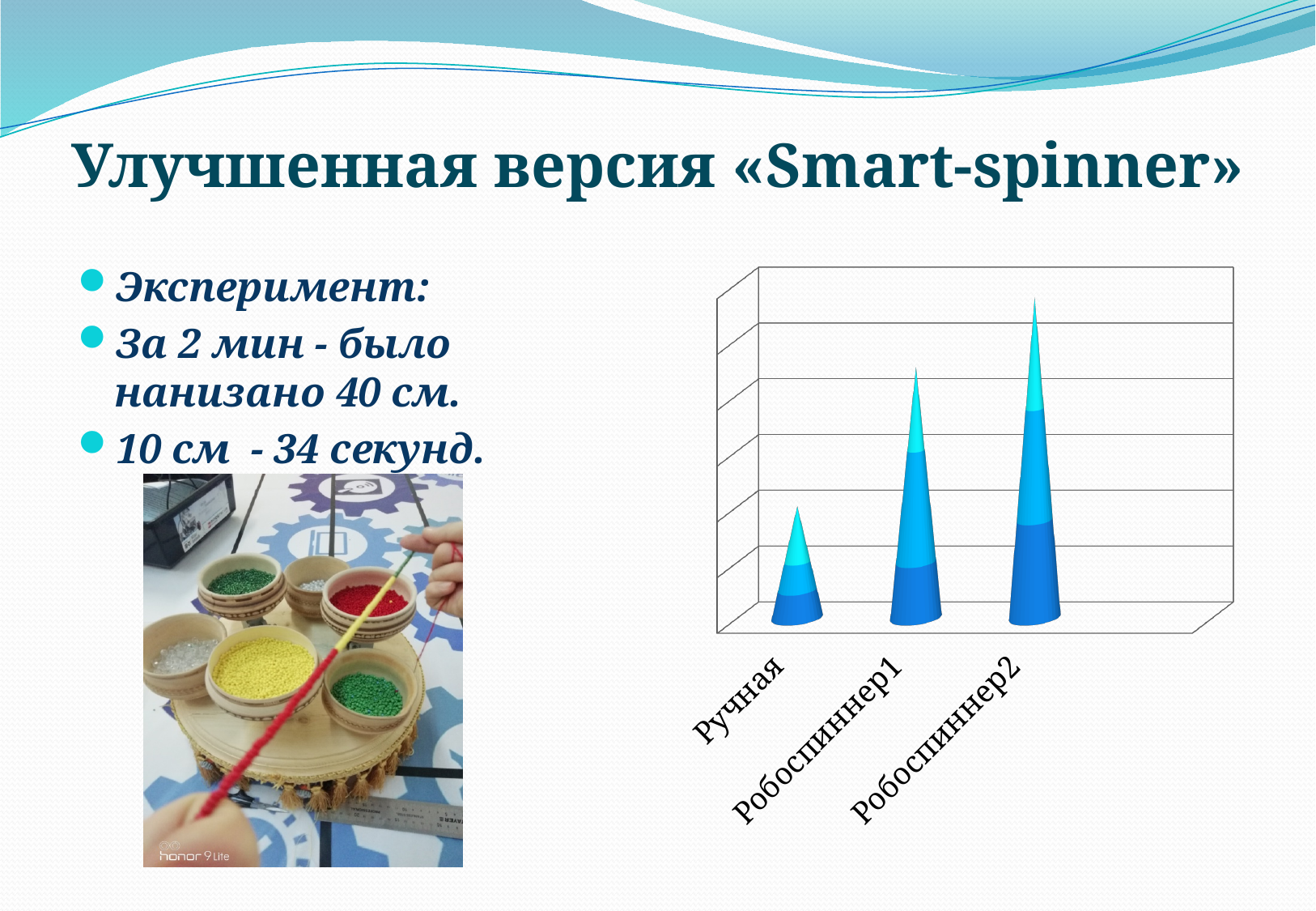
What is the label of the last (rightmost) category on the chart? Робоспиннер2 Which is larger on the chart, the value for Ручная or the value for Робоспиннер1? Робоспиннер1 Which category has the highest value on the chart? Робоспиннер2 Do the values on the chart rise or fall from left to right along the x axis? rise Which category has the lowest value on the chart? Ручная How many categories are plotted on the chart? 3 Which is larger on the chart, the value for Робоспиннер1 or the value for Робоспиннер2? Робоспиннер2 What is the label of the first (leftmost) category on the chart? Ручная What kind of chart is shown on the slide? bar chart